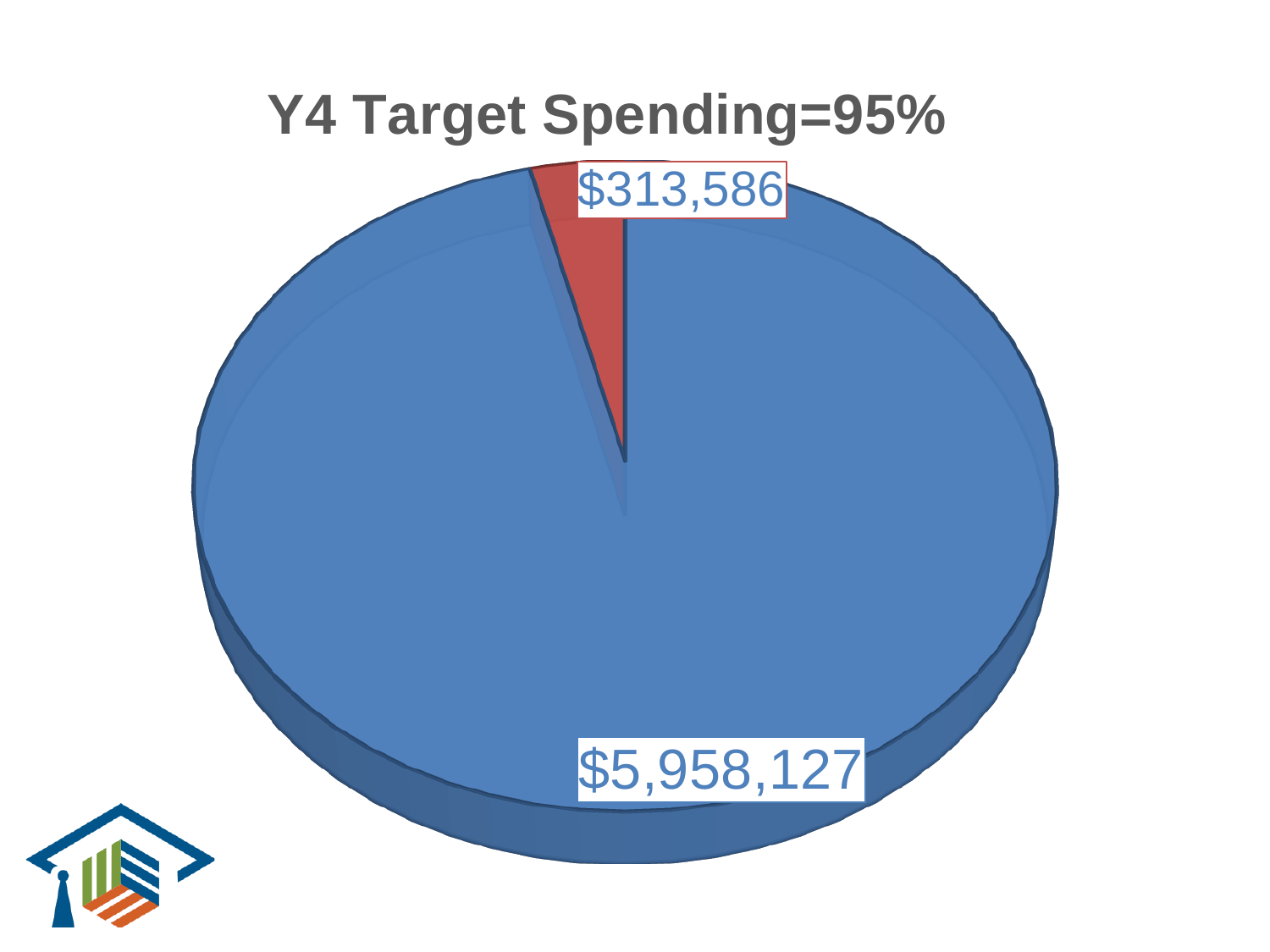
Which slice of the pie is the largest? The blue slice ($5,958,127) Which slice of the pie is the smallest? The red slice ($313,586) What value is labelled on the blue slice of the pie? $5,958,127 What share of the pie does the red slice ($313,586) represent? 5% What share of the pie does the blue slice ($5,958,127) represent? 95% What is the total of the two slice values in the pie? $6,271,713 What kind of chart is shown on the slide? Pie chart How many slices does the pie chart have? 2 What is the difference between the blue slice value and the red slice value? $5,644,541 Is the blue slice or the red slice larger? The blue slice What value is labelled on the red slice of the pie? $313,586 What is the title of the chart? Y4 Target Spending=95%